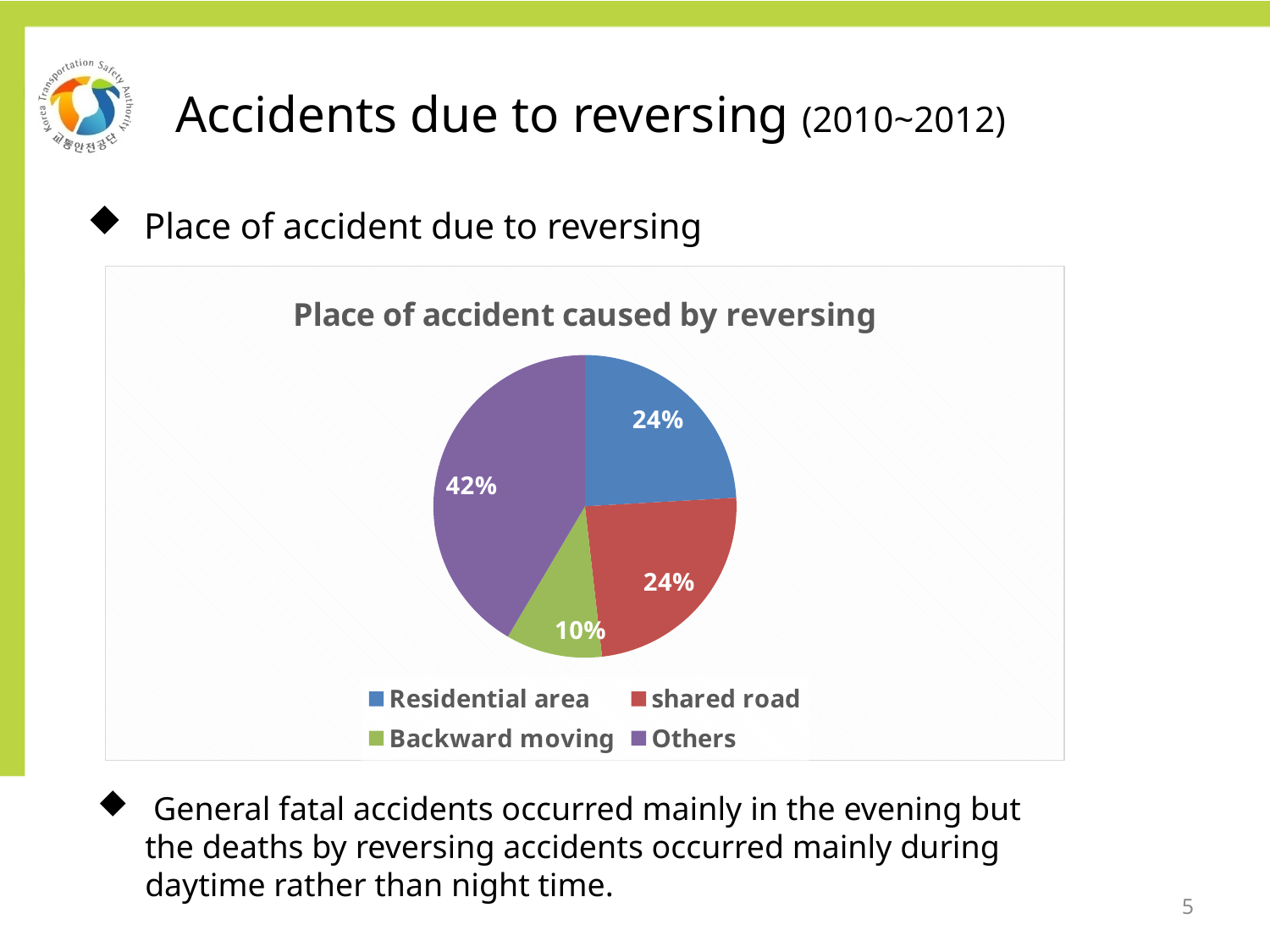
Which colour represents the Backward moving category in the legend? green What share of accidents caused by reversing occurred in a residential area? 24% What is the title of the chart? Place of accident caused by reversing Which is larger, the share for Others or the share for Residential area? Others What share of accidents caused by reversing occurred on a shared road? 24% What kind of chart is shown on the slide? pie chart How many categories does the pie chart show? 4 What share of the pie is labelled Backward moving? 10% What is the difference in percentage points between the Others slice and the Backward moving slice? 32 Which category has the largest share of the pie? Others Which category has the smallest share of the pie? Backward moving